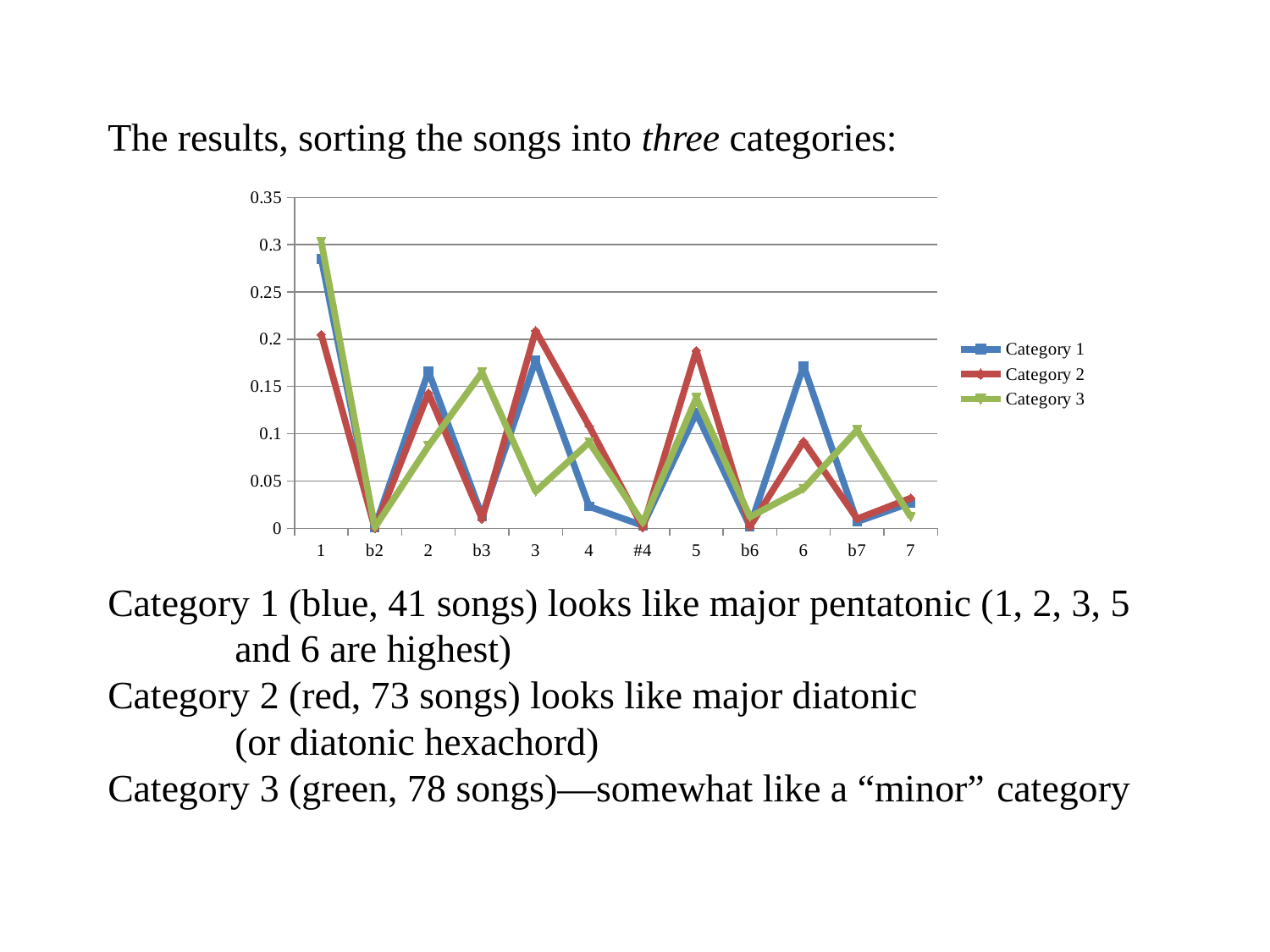
What colour is the line for Category 2 in the chart? red What kind of chart is shown on the slide? line chart Is the value for Category 1 at x-axis category 4 greater or less than 0.05? less Which x-axis category has the highest value for Category 1? 1 Which series has the highest value at x-axis category 6? Category 1 Which x-axis category has the highest value for Category 3? 1 Which series has the highest value at x-axis category b7? Category 3 How many categories are shown along the x axis of the chart? 12 Which series has the highest value at x-axis category b3? Category 3 Is the value for Category 1 at x-axis category 2 greater or less than 0.15? greater How many series does the chart's legend list? 3